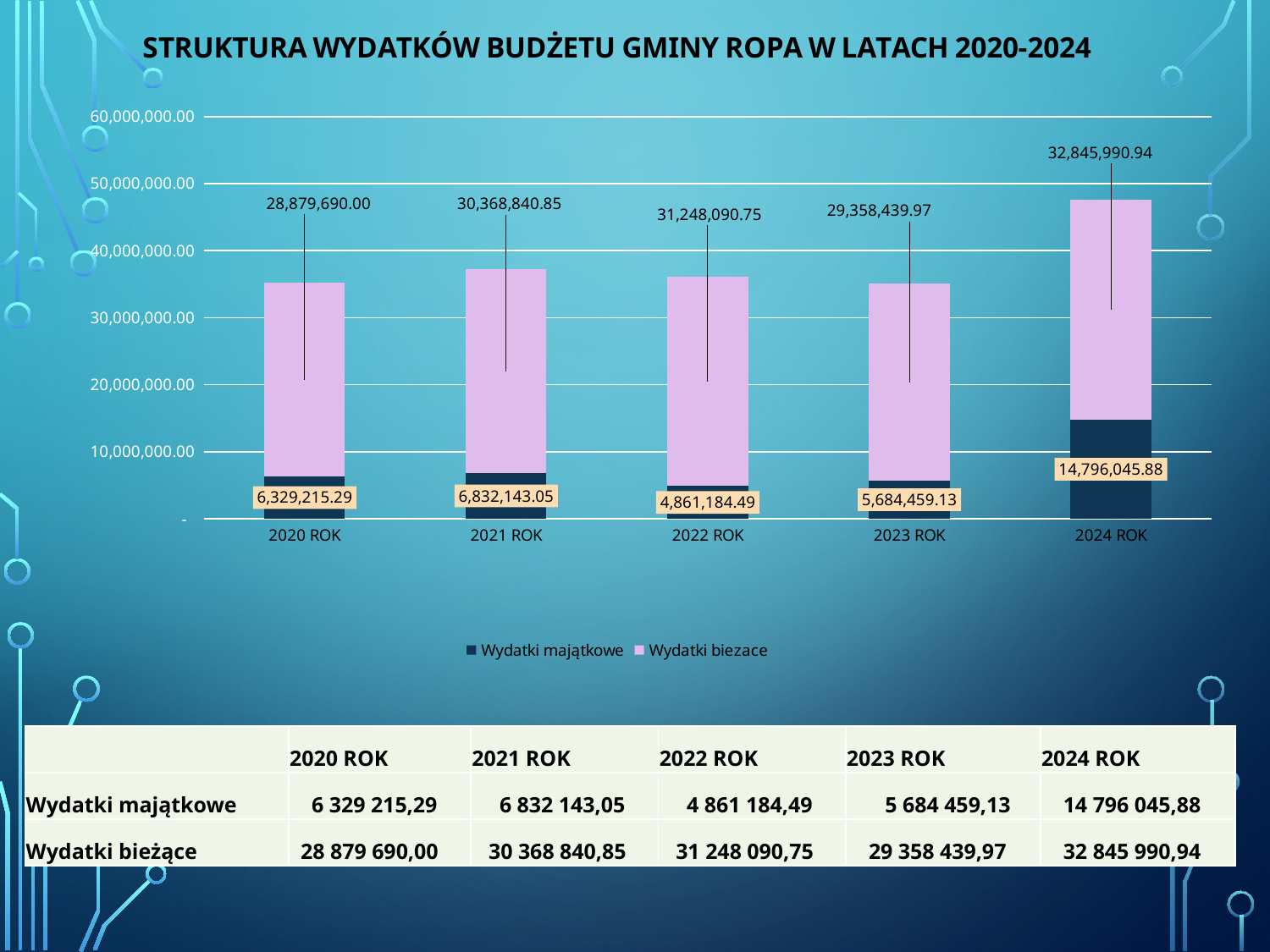
How many years are shown on the x axis of the chart? 5 How many series does the legend list? 2 Which is larger: Wydatki biezace in 2021 ROK or in 2023 ROK? 2021 ROK What is the value of Wydatki majątkowe for 2024 ROK? 14,796,045.88 What is the value of Wydatki biezace for 2022 ROK? 31,248,090.75 Which year has the highest value of Wydatki majątkowe? 2024 ROK What is the difference between Wydatki majątkowe in 2024 ROK and in 2020 ROK? 8,466,830.59 What is the value of Wydatki majątkowe for 2020 ROK? 6,329,215.29 Is the total of the stacked bar for 2020 ROK greater or less than 40,000,000.00? less Which year has the lowest value of Wydatki majątkowe? 2022 ROK What is the total of the stacked bar for 2024 ROK? 47,642,036.82 Which year has the lowest value of Wydatki biezace? 2020 ROK